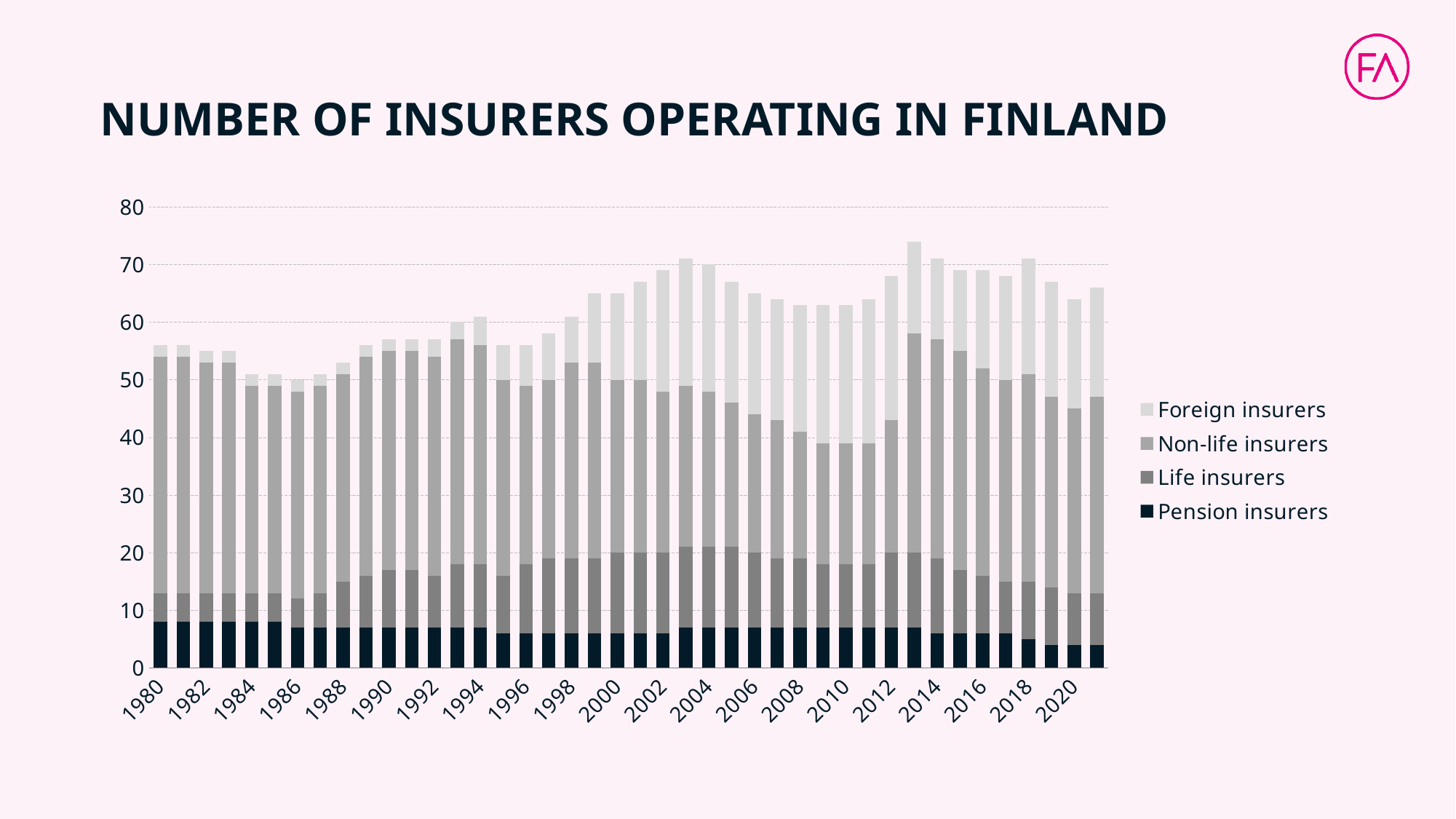
Is the number of pension insurers in 1980 greater or less than 10? less What is the title of the chart? NUMBER OF INSURERS OPERATING IN FINLAND Which year has the highest total number of insurers? 2013 Is the total number of insurers in 1986 greater or less than 60? less Which series is shown in the darkest colour at the bottom of each bar? Pension insurers Do the total bar heights rise or fall from 1980 to 1986? fall What kind of chart is shown on the slide? Stacked bar chart Is the total number of insurers in 2010 greater or less than 60? greater How many series does the legend list? 4 Which is larger, the total number of insurers in 2013 or in 1986? 2013 How many year labels are printed on the x axis? 21